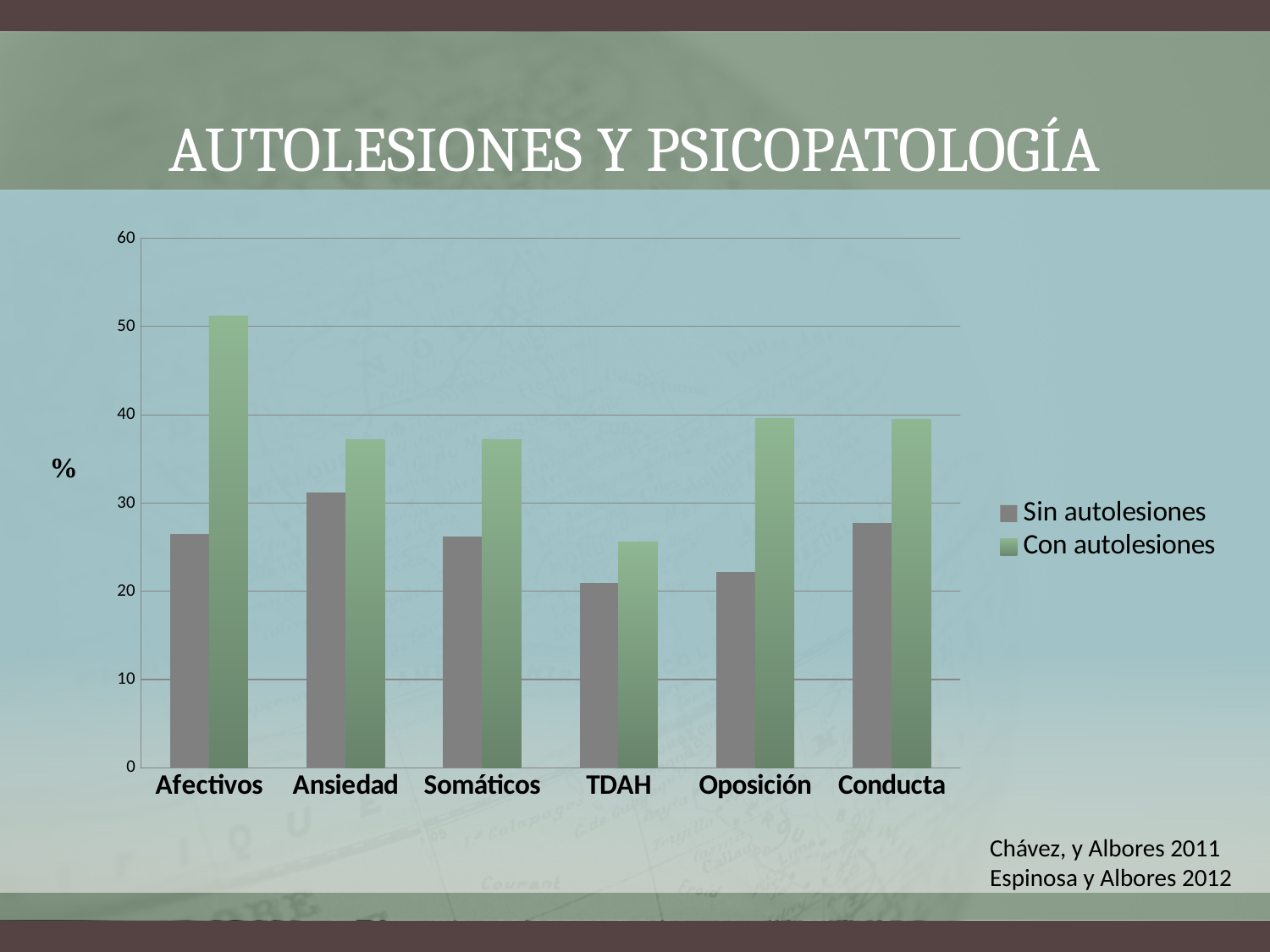
For Oposición, which is larger: Sin autolesiones or Con autolesiones? Con autolesiones How many series does the legend list? 2 What kind of chart is shown on the slide? bar chart Is the Sin autolesiones value for Afectivos greater or less than 30? less Is the Con autolesiones value for TDAH greater or less than 30? less What label is shown on the vertical axis? % Which category has the lowest value for Con autolesiones? TDAH Which category has the highest value for Sin autolesiones? Ansiedad Is the Con autolesiones value for Afectivos greater or less than 40? greater How many categories are shown on the x axis? 6 Which is larger: the Con autolesiones value for Afectivos or for Conducta? Afectivos Which category has the highest value for Con autolesiones? Afectivos